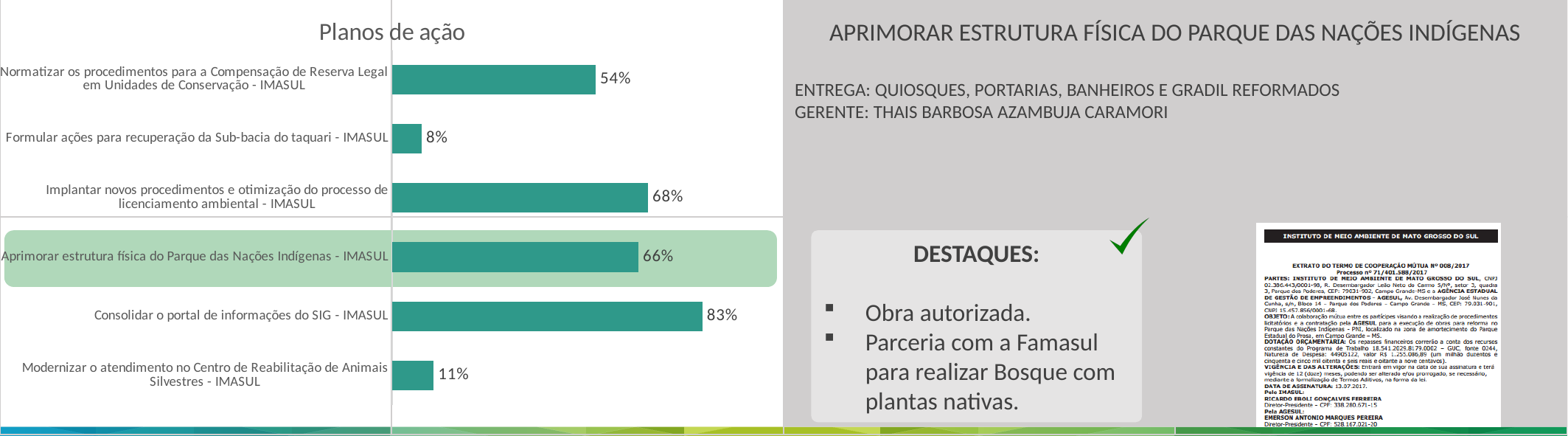
What is the value for "Aprimorar estrutura física do Parque das Nações Indígenas - IMASUL"? 66% Which action plan has the highest value in the chart? Consolidar o portal de informações do SIG - IMASUL What is the title of the chart? Planos de ação Which action plan has the lowest value in the chart? Formular ações para recuperação da Sub-bacia do taquari - IMASUL How many action plans (categories) are shown in the chart? 6 Which has a larger value: "Implantar novos procedimentos e otimização do processo de licenciamento ambiental - IMASUL" or "Aprimorar estrutura física do Parque das Nações Indígenas - IMASUL"? Implantar novos procedimentos e otimização do processo de licenciamento ambiental - IMASUL Which category in the chart is highlighted with a green background? Aprimorar estrutura física do Parque das Nações Indígenas - IMASUL What is the difference between the values for "Consolidar o portal de informações do SIG - IMASUL" and "Normatizar os procedimentos para a Compensação de Reserva Legal em Unidades de Conservação - IMASUL"? 29% What is the value for "Modernizar o atendimento no Centro de Reabilitação de Animais Silvestres - IMASUL"? 11% What kind of chart is shown on the slide? Bar chart What is the value for "Consolidar o portal de informações do SIG - IMASUL" in the Planos de ação chart? 83% What is the value for "Formular ações para recuperação da Sub-bacia do taquari - IMASUL"? 8%